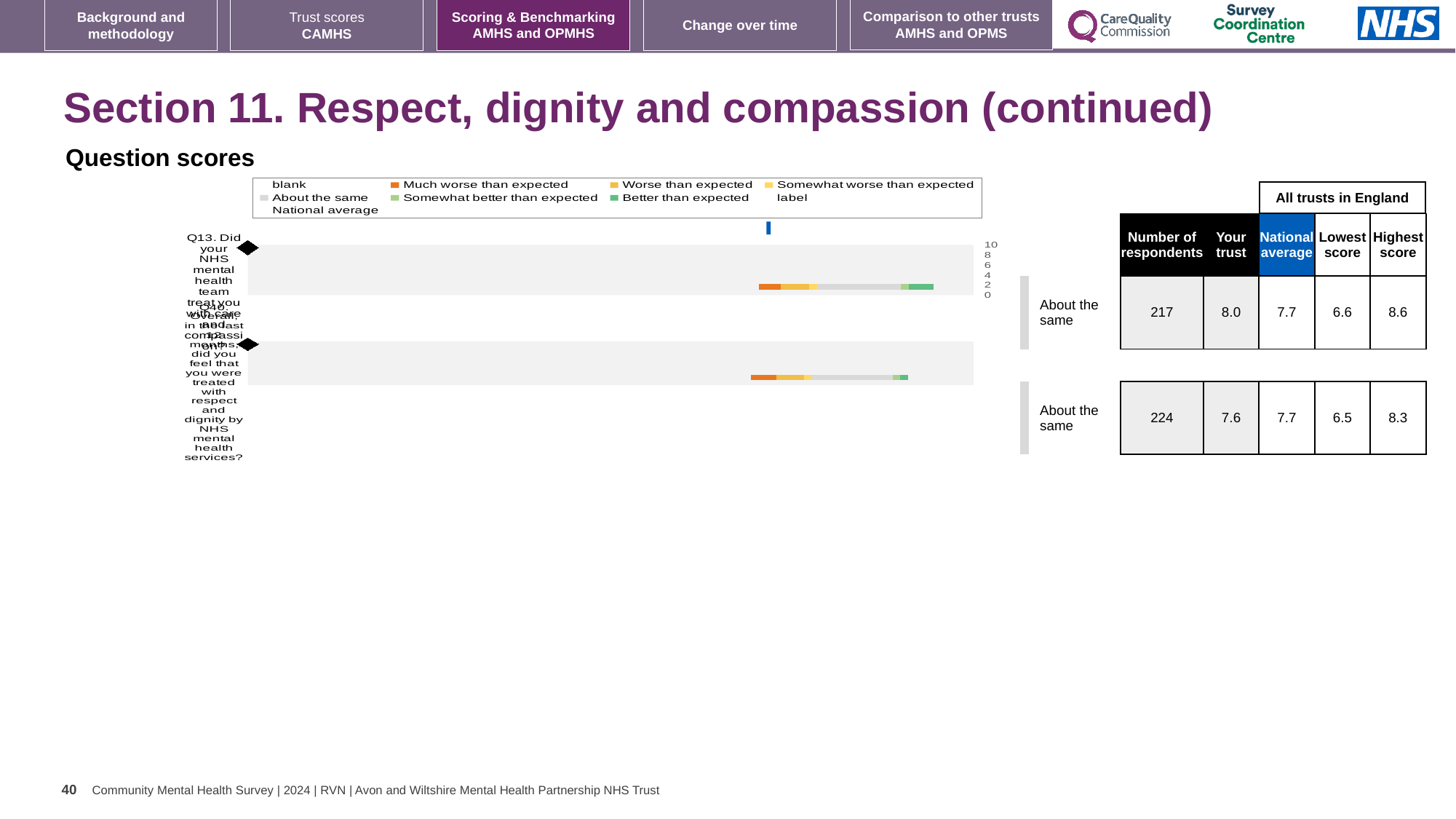
In the table beside the chart, what is the 'Your trust' score for Q13 (care and compassion)? 8.0 In the table beside the chart, which question has the higher 'Your trust' score, Q13 or Q10? Q13 In the table beside the chart, what is the 'Your trust' score for Q10 (respect and dignity)? 7.6 How many entries does the legend of the Question scores chart list? 9 In the table beside the chart, what is the number of respondents for Q13? 217 In the table beside the chart, what is the highest score across all trusts in England for Q10? 8.3 Which legend entry in the Question scores chart is shown in orange? Much worse than expected How many question rows (categories) are plotted in the Question scores chart? 2 In the table beside the chart, what is the difference between the 'Your trust' score and the national average for Q13? 0.3 In the table beside the chart, what is the lowest score across all trusts in England for Q13? 6.6 What is the highest tick value shown on the axis of the Question scores chart? 10 What kind of chart is shown under 'Question scores'? bar chart